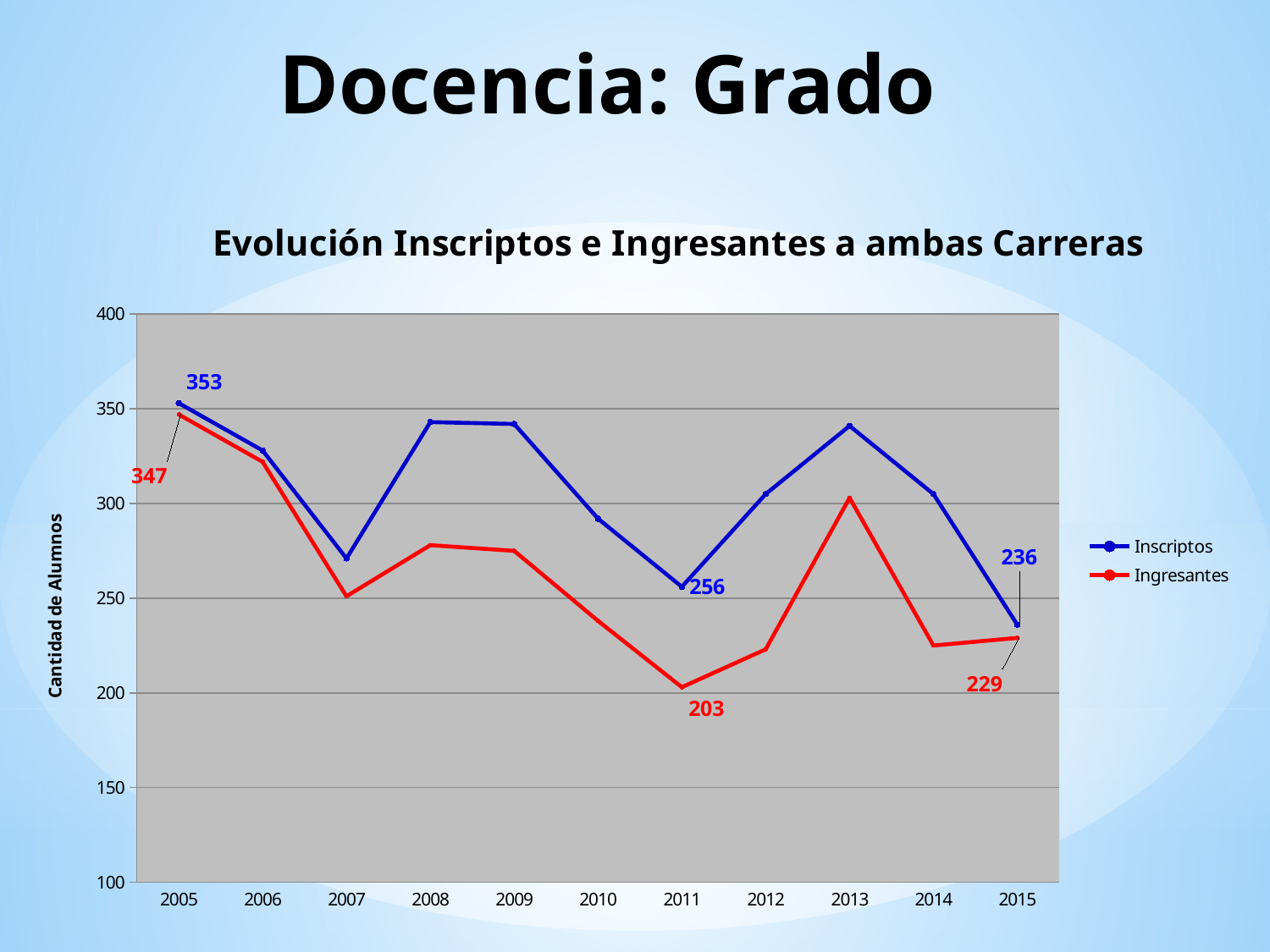
What is the title of the chart? Evolución Inscriptos e Ingresantes a ambas Carreras What is the difference between Inscriptos in 2005 and Inscriptos in 2015? 117 What type of chart is shown on the slide? line chart What is the difference between Inscriptos and Ingresantes in 2011? 53 Which series is higher in 2013, Inscriptos or Ingresantes? Inscriptos What is the value of Inscriptos in 2005? 353 What is the value of Inscriptos in 2015? 236 How many years are shown on the x axis? 11 How many series does the legend list? 2 Is the value for Ingresantes in 2007 greater or less than 300? less What is the value of Ingresantes in 2011? 203 What is the value of Ingresantes in 2015? 229